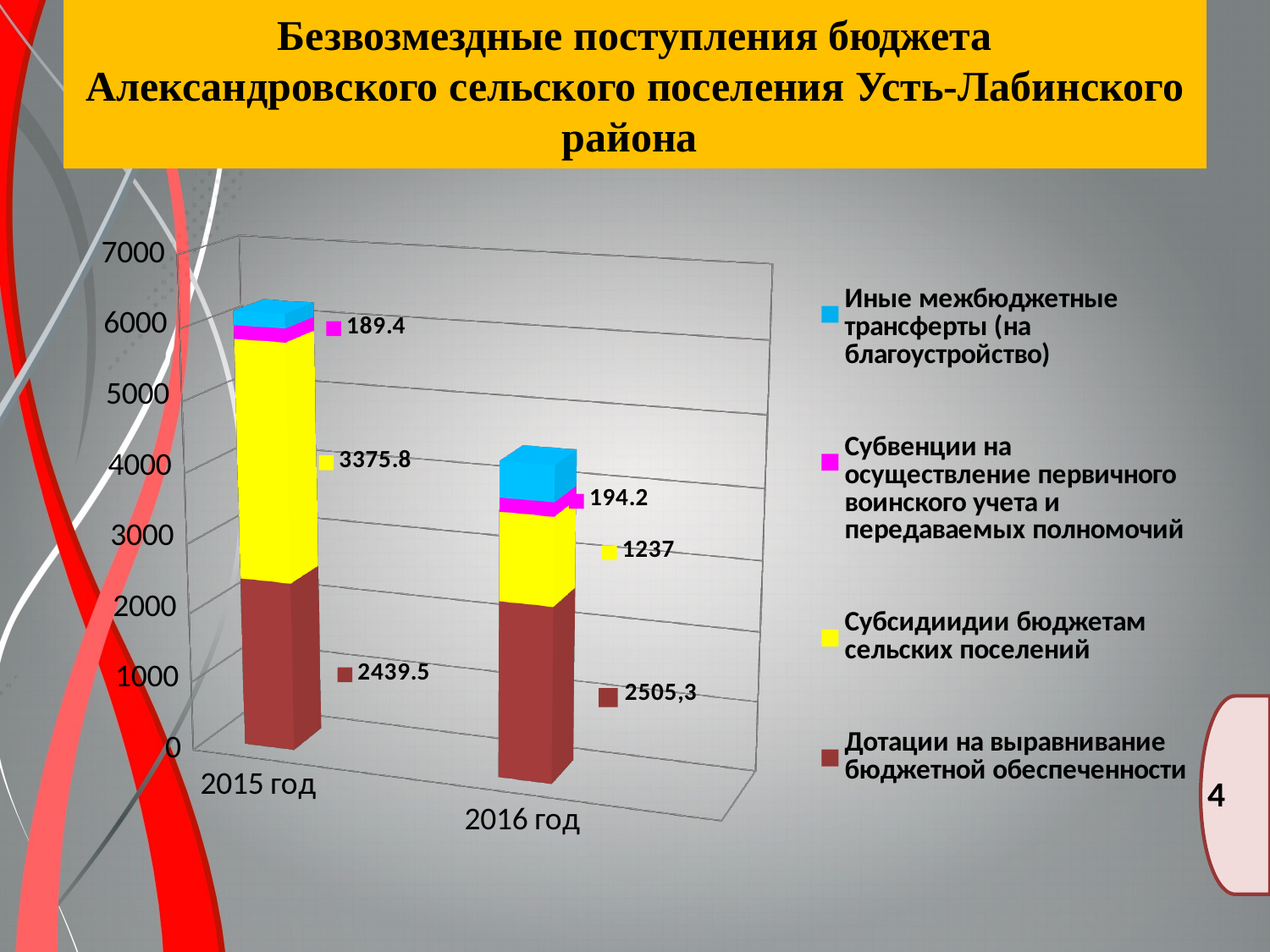
Which colour represents 'Иные межбюджетные трансферты (на благоустройство)' in the legend? blue What is the value of 'Дотации на выравнивание бюджетной обеспеченности' for 2016 год? 2505,3 What is the value of 'Субсидиидии бюджетам сельских поселений' for 2016 год? 1237 What is the value of 'Субсидиидии бюджетам сельских поселений' for 2015 год? 3375.8 Which year has the larger value for 'Субсидиидии бюджетам сельских поселений', 2015 год or 2016 год? 2015 год By how much did 'Субсидиидии бюджетам сельских поселений' decrease from 2015 год to 2016 год? 2138.8 What is the value of 'Субвенции на осуществление первичного воинского учета и передаваемых полномочий' for 2015 год? 189.4 Is the total height of the 2016 год stacked bar greater or less than 5000? less What is the value of 'Субвенции на осуществление первичного воинского учета и передаваемых полномочий' for 2016 год? 194.2 How many categories (years) are shown on the x axis? 2 How many series does the legend list? 4 What type of chart is shown on the slide? stacked bar chart